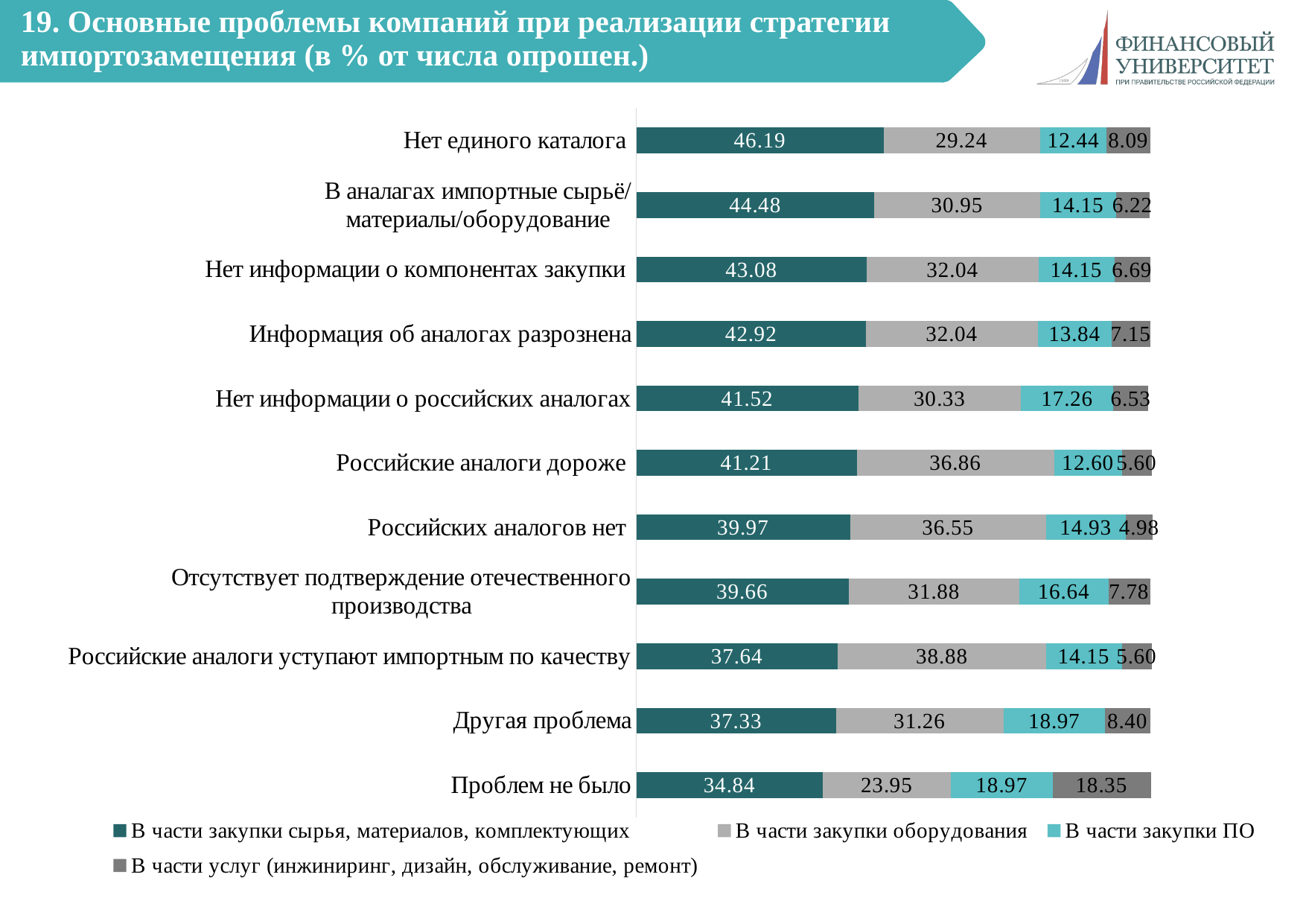
Which is larger for 'Российские аналоги дороже': the value for 'В части закупки оборудования' or for 'В части закупки ПО'? В части закупки оборудования Which category has the highest value in the series 'В части закупки сырья, материалов, комплектующих'? Нет единого каталога What is the total of the stacked bar for 'Нет единого каталога'? 95.96 What is the value for 'Проблем не было' in the series 'В части услуг (инжиниринг, дизайн, обслуживание, ремонт)'? 18.35 How many categories (problems) are plotted on the chart? 11 What is the value for 'Нет единого каталога' in the series 'В части закупки сырья, материалов, комплектующих'? 46.19 How many series does the legend list? 4 What is the difference between the 'В части закупки сырья, материалов, комплектующих' values for 'Нет единого каталога' and 'Проблем не было'? 11.35 Which category has the lowest value in the series 'В части закупки сырья, материалов, комплектующих'? Проблем не было What type of chart is shown on the slide? Stacked bar chart What is the value for 'Российские аналоги уступают импортным по качеству' in the series 'В части закупки оборудования'? 38.88 Which category has the highest value in the series 'В части услуг (инжиниринг, дизайн, обслуживание, ремонт)'? Проблем не было